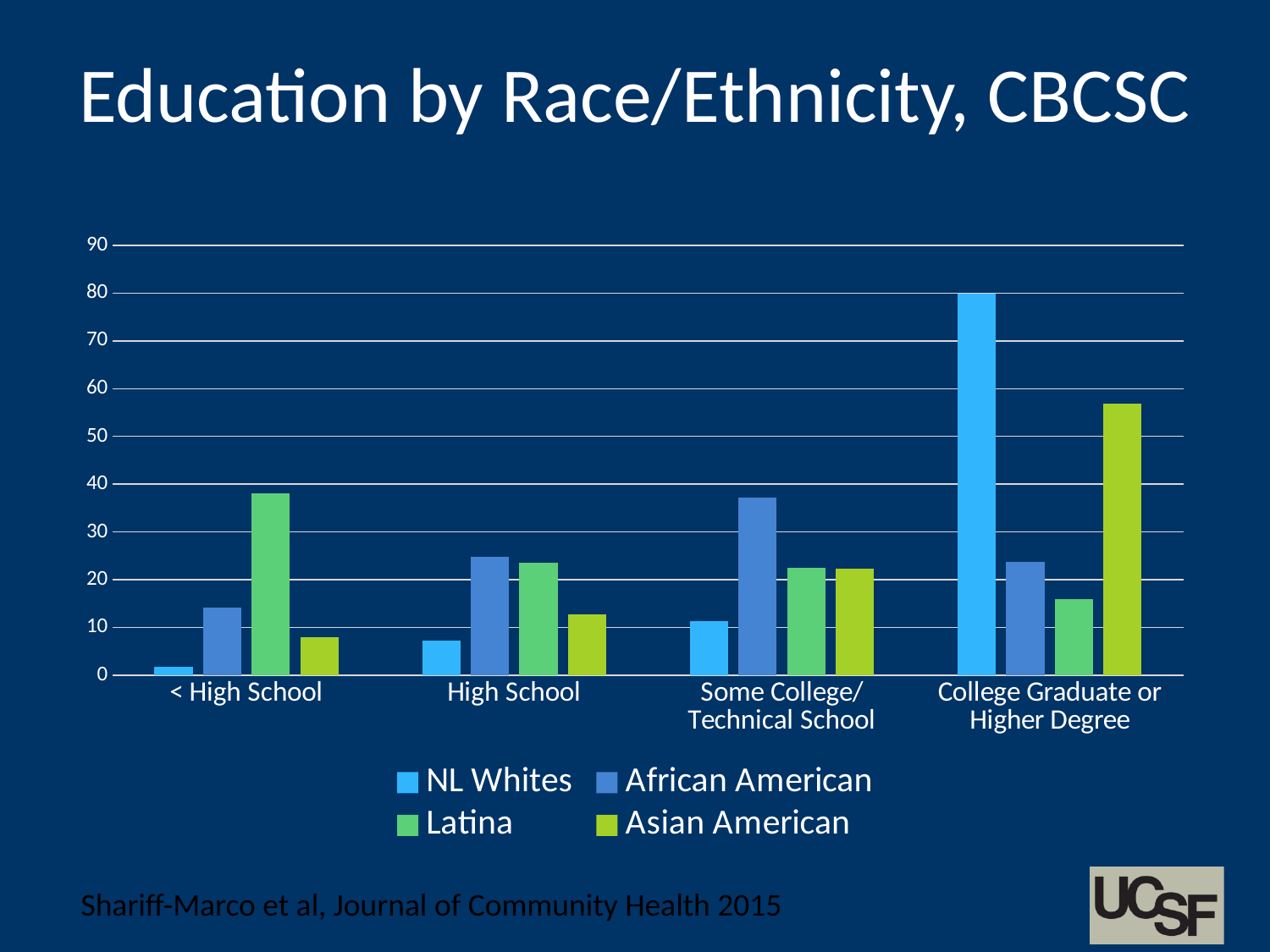
Which group has the highest value in the College Graduate or Higher Degree category? NL Whites How many series does the legend list? 4 Is the value for Latina in the < High School category greater or less than 30? greater Which group has the lowest value in the < High School category? NL Whites Do the NL Whites values rise or fall moving from < High School to College Graduate or Higher Degree? rise Is the value for NL Whites in the College Graduate or Higher Degree category greater or less than 70? greater What is the title of the chart? Education by Race/Ethnicity, CBCSC In the Some College/Technical School category, which is larger: African American or Latina? African American What kind of chart is shown on the slide? bar chart Is the value for Asian American in the College Graduate or Higher Degree category greater or less than 50? greater How many education categories are shown on the x axis? 4 Which group has the highest value in the < High School category? Latina